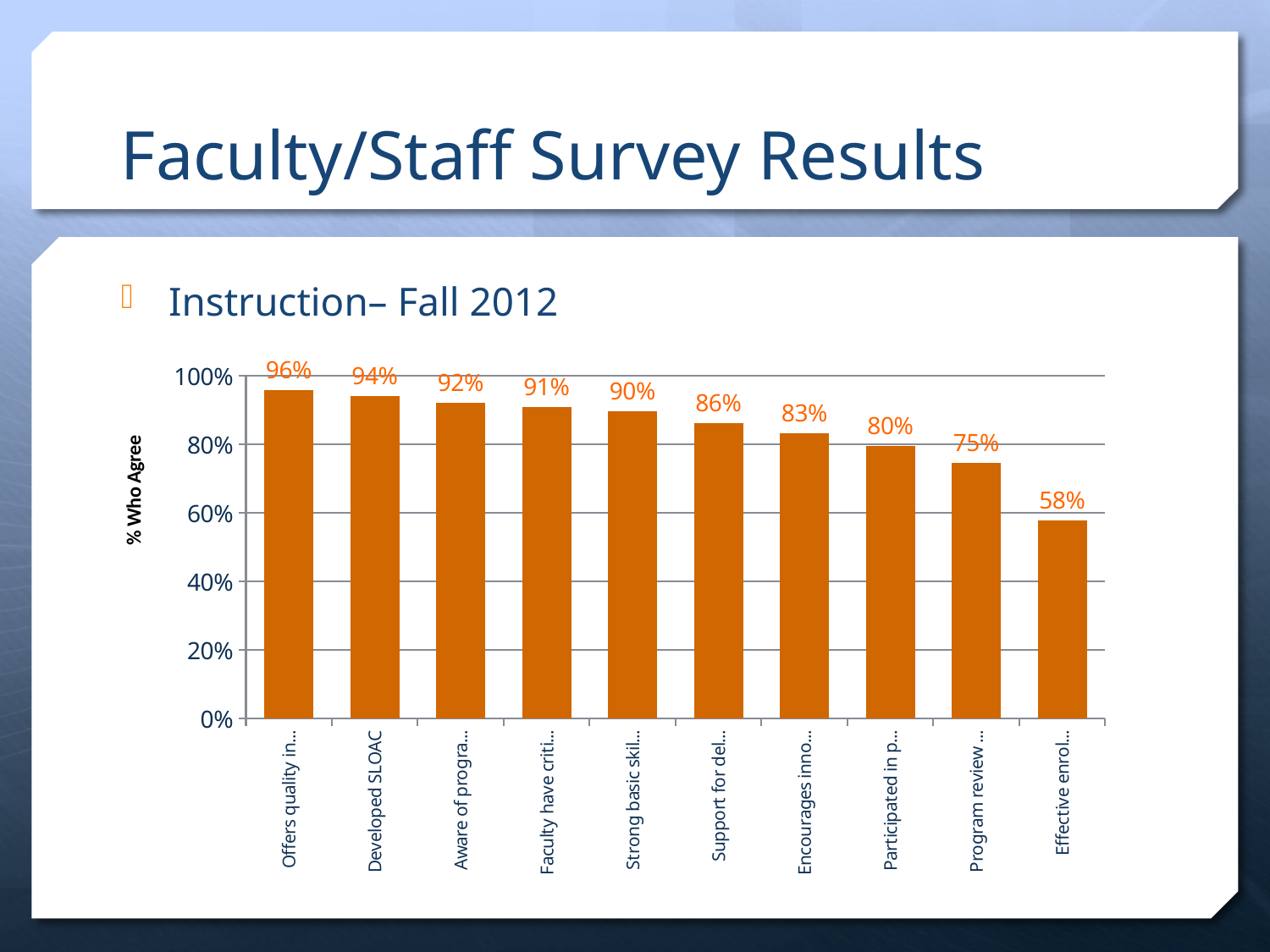
Which is larger, the value for "Support for del..." or the value for "Encourages inno..."? Support for del... What is the difference between the values for "Offers quality in..." and "Effective enrol..."? 38% What value is shown for the bar labelled "Effective enrol..."? 58% Do the values rise or fall from left to right across the chart? Fall What is the label on the vertical axis of the chart? % Who Agree What kind of chart is shown on the slide? Bar chart Which category has the lowest percentage who agree? Effective enrol... Which category has the highest percentage who agree? Offers quality in... Is the value for "Participated in p..." greater or less than 60%? greater What value is shown for the bar labelled "Program review ..."? 75% How many bars are plotted in the chart? 10 What percentage of respondents agree with the item labelled "Developed SLOAC"? 94%